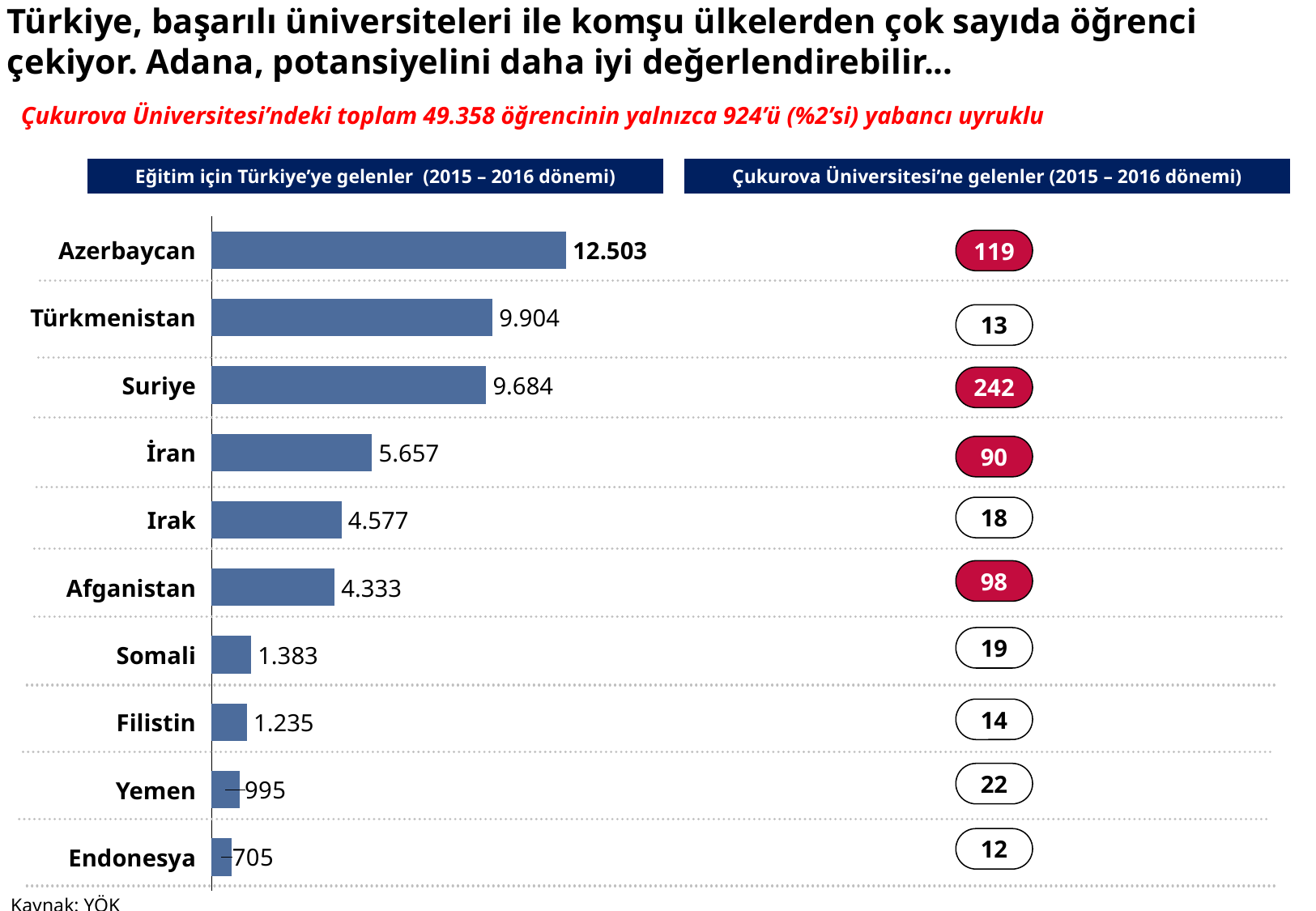
In the 'Eğitim için Türkiye'ye gelenler' chart, what is the difference between the values for Azerbaycan and Türkmenistan? 2.599 In the 'Eğitim için Türkiye'ye gelenler' chart, which country has the lowest value? Endonesya In the 'Eğitim için Türkiye'ye gelenler' chart, what is the difference between the values for Irak and Afganistan? 244 What kind of chart is shown under the heading 'Eğitim için Türkiye'ye gelenler (2015 – 2016 dönemi)'? bar chart In the 'Çukurova Üniversitesi'ne gelenler (2015 – 2016 dönemi)' column, what is the value for Suriye? 242 In the 'Eğitim için Türkiye'ye gelenler' chart, what is the value for Azerbaycan? 12.503 In the 'Eğitim için Türkiye'ye gelenler' chart, what is the value for İran? 5.657 In the 'Çukurova Üniversitesi'ne gelenler (2015 – 2016 dönemi)' column, which country has the highest value? Suriye In the 'Eğitim için Türkiye'ye gelenler' chart, how many countries are listed? 10 In the 'Eğitim için Türkiye'ye gelenler' chart, which country has the highest value? Azerbaycan In the 'Eğitim için Türkiye'ye gelenler' chart, what is the value for Endonesya? 705 In the 'Eğitim için Türkiye'ye gelenler' chart, which is larger, the value for Türkmenistan or the value for Suriye? Türkmenistan